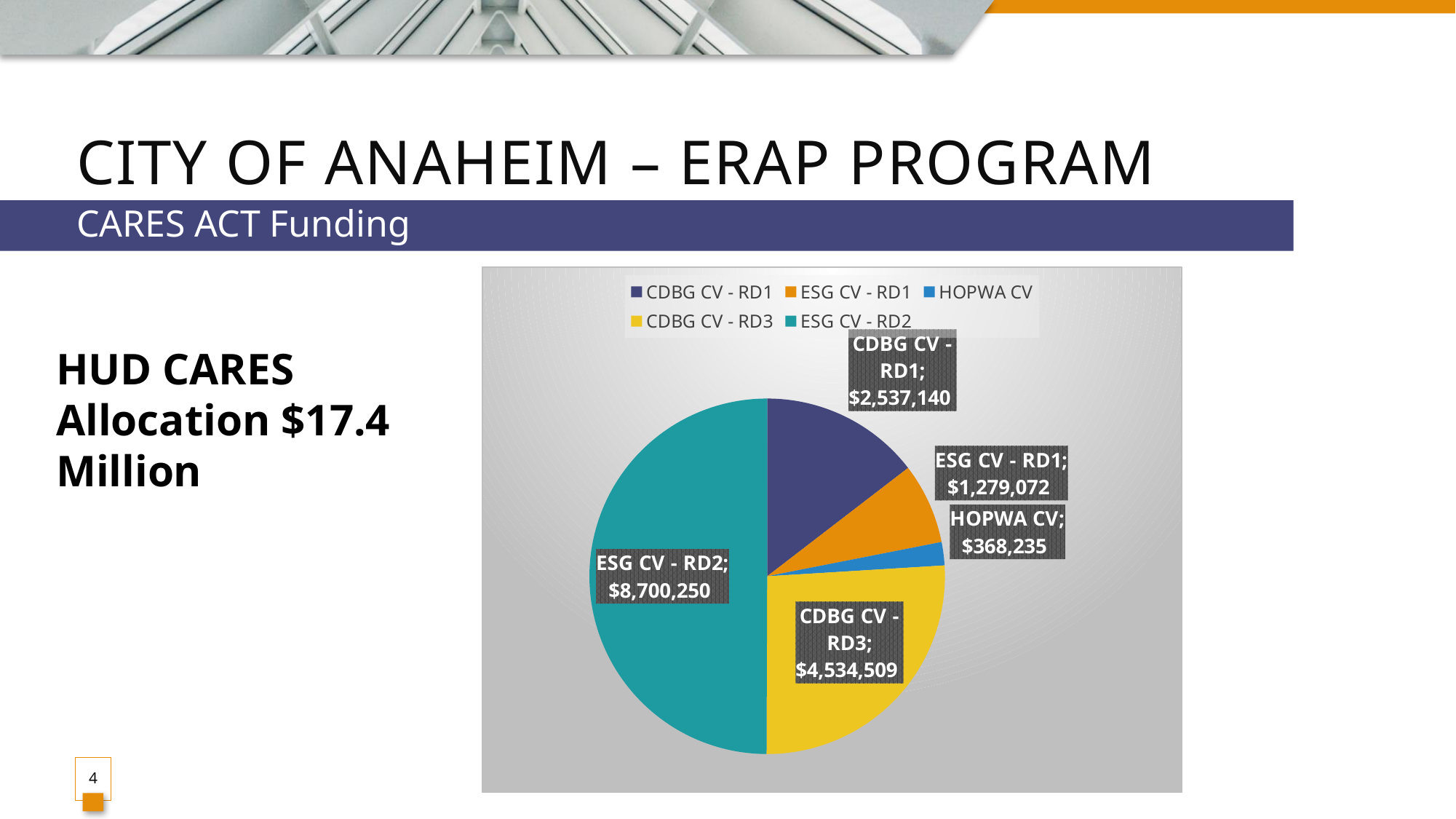
What is the value for ESG CV - RD2? $8,700,250 What is the value for CDBG CV - RD3? $4,534,509 Which category has the largest slice of the pie? ESG CV - RD2 What is the difference between ESG CV - RD2 and CDBG CV - RD3? $4,165,741 What is the difference between CDBG CV - RD1 and ESG CV - RD1? $1,258,068 What is the value for ESG CV - RD1? $1,279,072 What is the value for HOPWA CV? $368,235 Which category has the smallest slice of the pie? HOPWA CV What kind of chart is shown on the slide? Pie chart Which is larger, CDBG CV - RD1 or CDBG CV - RD3? CDBG CV - RD3 How many slices does the pie chart have? 5 What colour is the ESG CV - RD2 slice? Teal